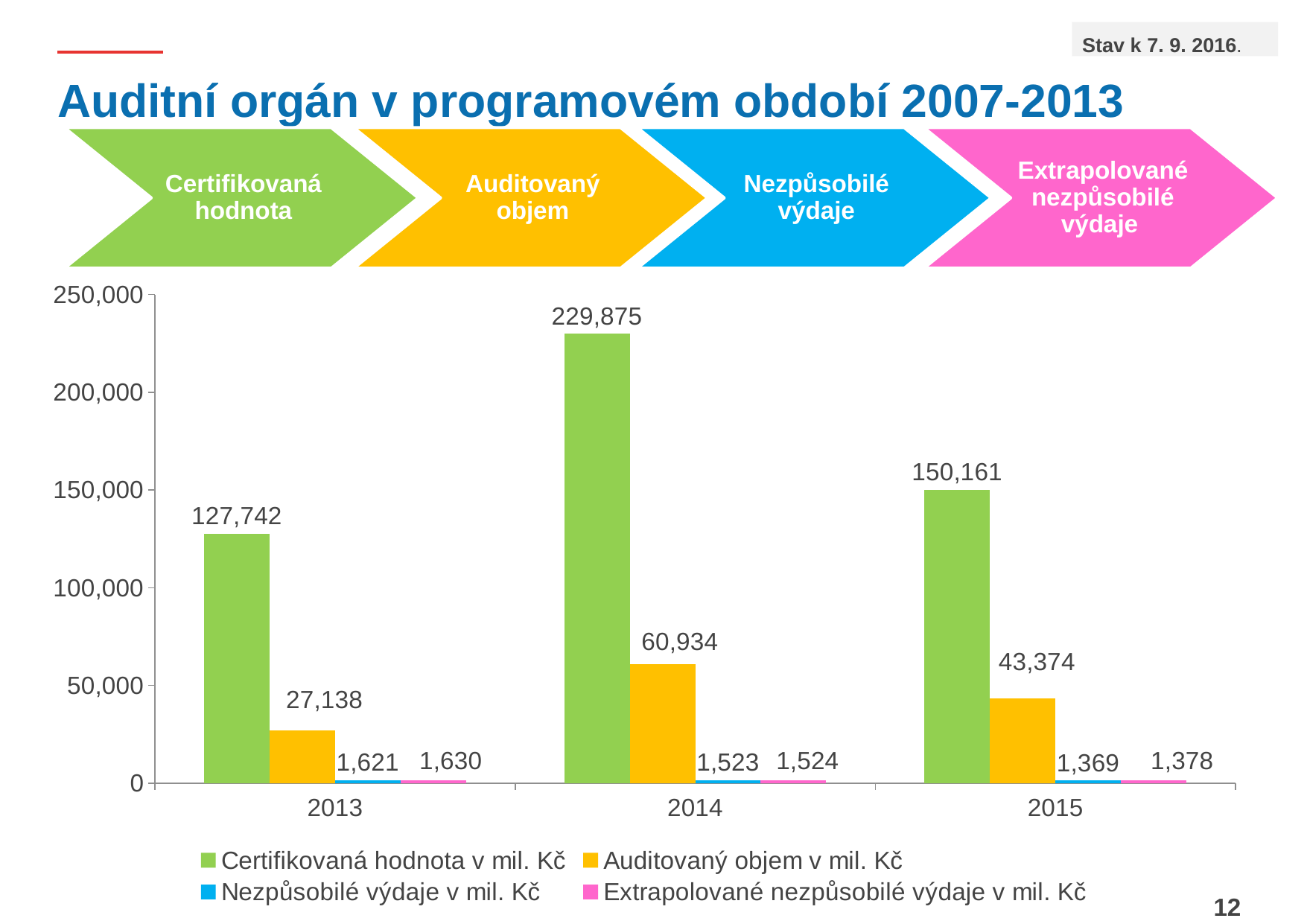
Is the value of Certifikovaná hodnota v mil. Kč for 2015 greater or less than 100,000? greater What is the value of Auditovaný objem v mil. Kč for 2015? 43,374 Which is larger: Auditovaný objem v mil. Kč in 2014 or in 2015? 2014 What is the value of Nezpůsobilé výdaje v mil. Kč for 2013? 1,621 How many series does the legend list? 4 In which year is Certifikovaná hodnota v mil. Kč highest? 2014 In which year is Auditovaný objem v mil. Kč lowest? 2013 What is the value of Extrapolované nezpůsobilé výdaje v mil. Kč for 2014? 1,524 What is the difference between Certifikovaná hodnota v mil. Kč in 2014 and in 2013? 102,133 What kind of chart is shown on the slide? bar chart How many years are shown on the x axis? 3 What is the value of Certifikovaná hodnota v mil. Kč for 2014? 229,875